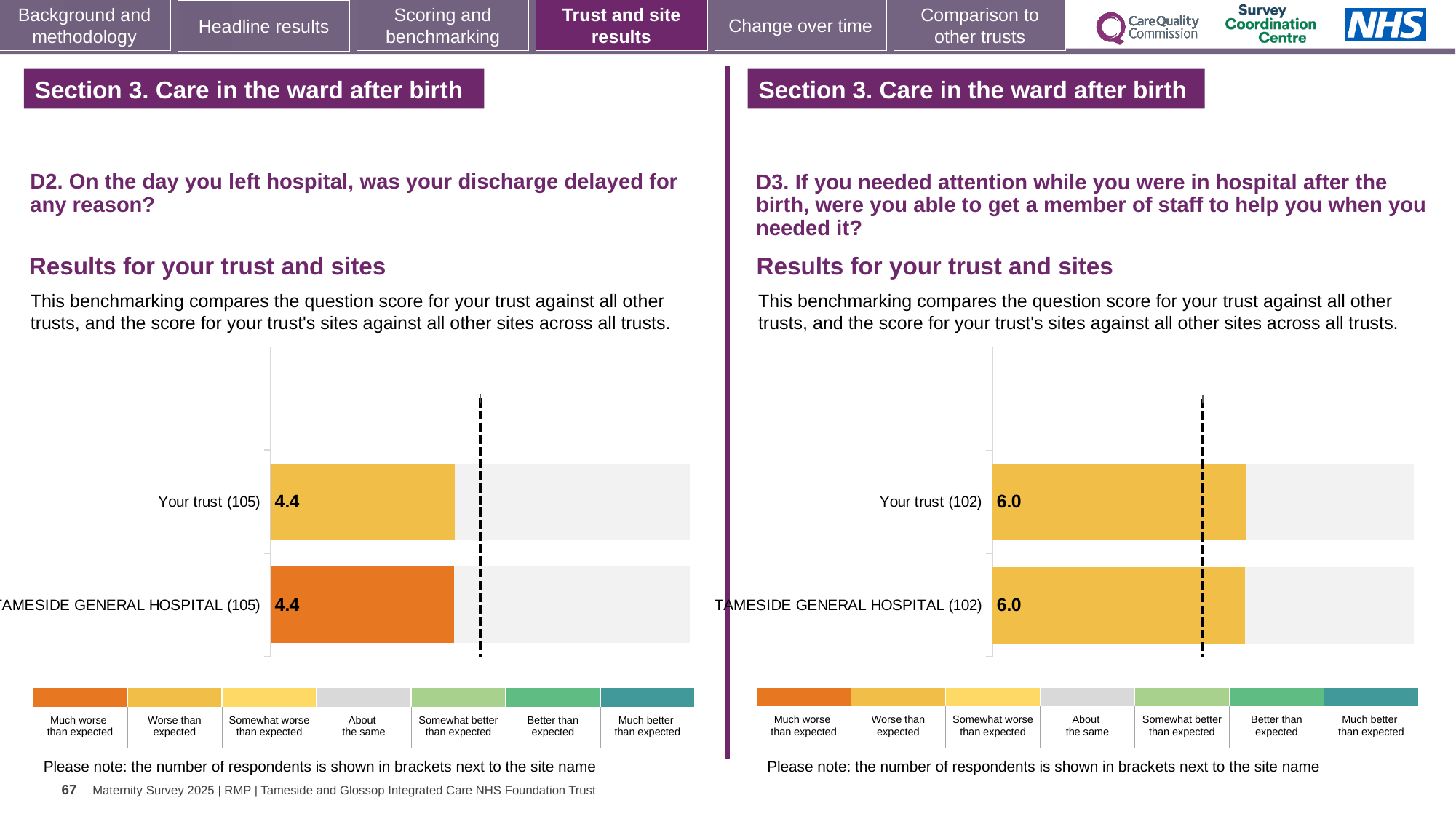
In the D3 chart on the right, what is the score for TAMESIDE GENERAL HOSPITAL? 6.0 In the D2 chart on the left, what is the difference between the score for Your trust and the score for TAMESIDE GENERAL HOSPITAL? 0.0 What kind of chart is used on the left for question D2? Bar chart How many bars are plotted in the D3 chart on the right? 2 In the D2 chart on the left, what is the score for TAMESIDE GENERAL HOSPITAL? 4.4 In the D2 chart on the left, what is the score for Your trust? 4.4 In the D3 chart on the right, what is the score for Your trust? 6.0 How many bars are plotted in the D2 chart on the left? 2 In the D3 chart on the right, how many respondents are shown in brackets next to TAMESIDE GENERAL HOSPITAL? 102 In the D2 chart on the left, how many respondents are shown in brackets next to Your trust? 105 In the D3 chart on the right, what is the difference between the score for Your trust and the score for TAMESIDE GENERAL HOSPITAL? 0.0 In the D2 chart on the left, which benchmark category does the colour of the TAMESIDE GENERAL HOSPITAL bar correspond to in the legend? Much worse than expected